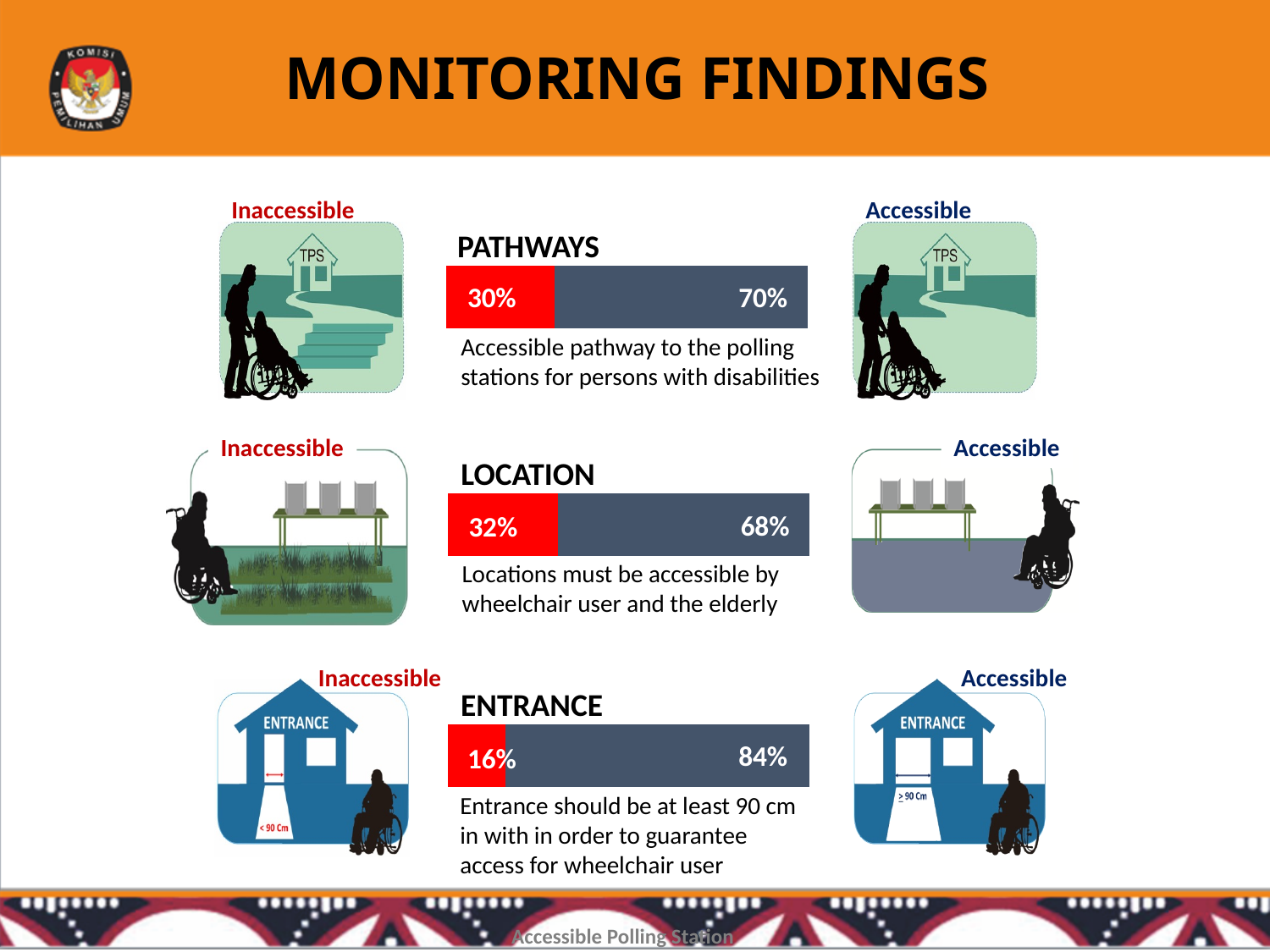
In the LOCATION bar, what percentage is shown in the dark (Accessible) segment? 68% In the LOCATION bar, what percentage is shown in the red (Inaccessible) segment? 32% What type of chart is used to show the PATHWAYS, LOCATION and ENTRANCE percentages? Bar chart Across the three bars (PATHWAYS, LOCATION, ENTRANCE), which has the lowest Inaccessible percentage? ENTRANCE Which is larger: the Inaccessible percentage for LOCATION or the Inaccessible percentage for PATHWAYS? LOCATION In the PATHWAYS bar, what percentage is shown in the red (Inaccessible) segment? 30% In the ENTRANCE bar, what percentage is shown in the red (Inaccessible) segment? 16% In the PATHWAYS bar, what percentage is shown in the dark (Accessible) segment? 70% Across the three bars (PATHWAYS, LOCATION, ENTRANCE), which has the highest Accessible percentage? ENTRANCE How many bars are shown on the slide? 3 In the ENTRANCE bar, what percentage is shown in the dark (Accessible) segment? 84% In the ENTRANCE bar, what is the difference between the Accessible and Inaccessible percentages? 68%